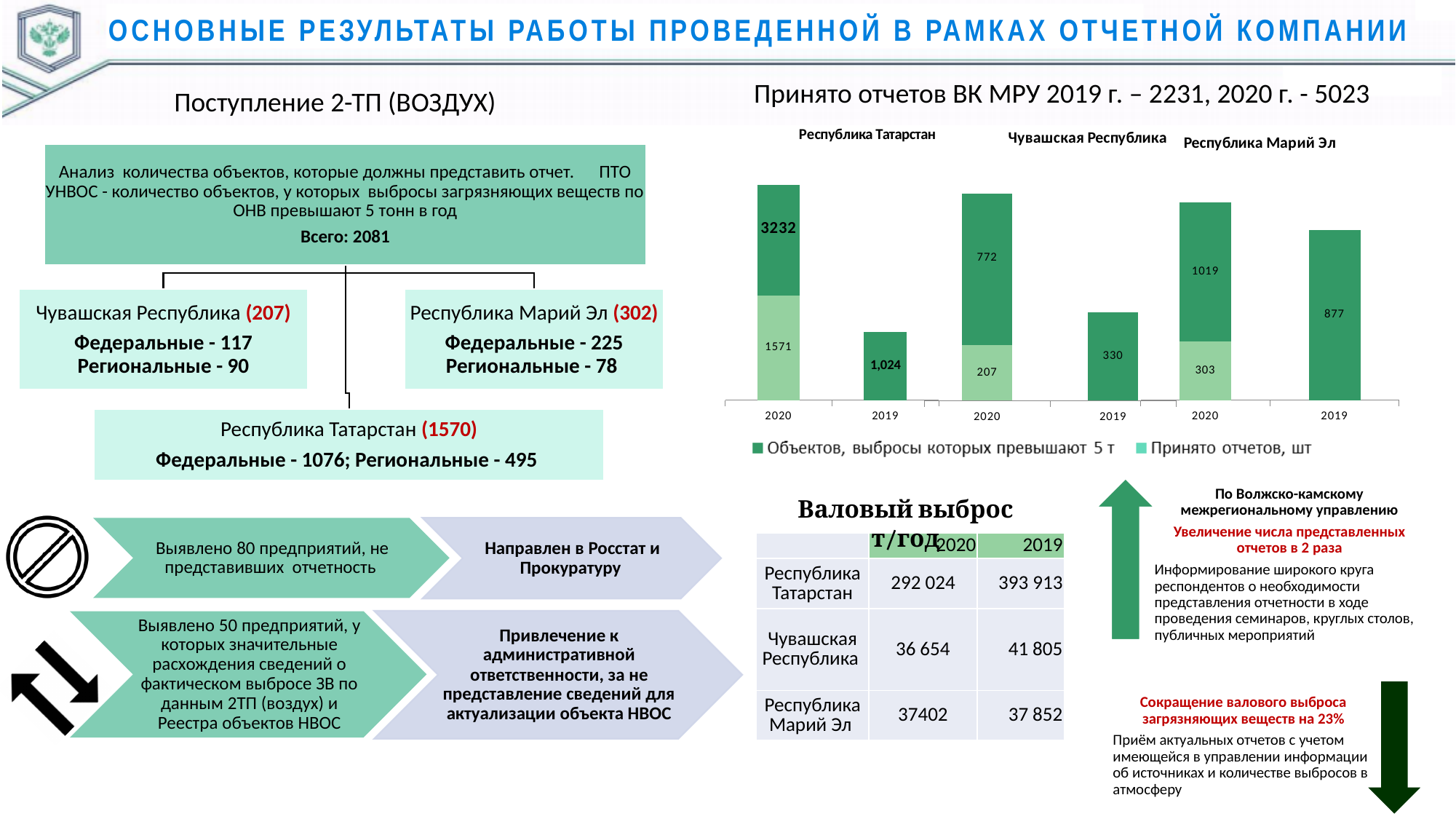
In the stacked bar chart, which is larger: the 2019 bar for Чувашская Республика or the 2019 bar for Республика Марий Эл? Республика Марий Эл In the stacked bar chart, what value is labelled on the 2019 bar for Республика Марий Эл? 877 How many bars are plotted in the stacked bar chart? 6 In the stacked bar chart, what value is labelled on the 2019 bar for Республика Татарстан? 1,024 In the stacked bar chart, what is the difference between the 'Объектов, выбросы которых превышают 5 т' value for Республика Марий Эл in 2020 (1019) and its 2019 bar value (877)? 142 What type of chart is used to show the reports and objects by region? Bar chart In the stacked bar chart, what is the total of the 2020 bar for Республика Татарстан? 3232 How many series does the legend of the stacked bar chart list? 2 In the stacked bar chart, what is the total of the 2020 bar for Чувашская Республика? 772 In the stacked bar chart, what is the total of the 2020 bar for Республика Марий Эл? 1019